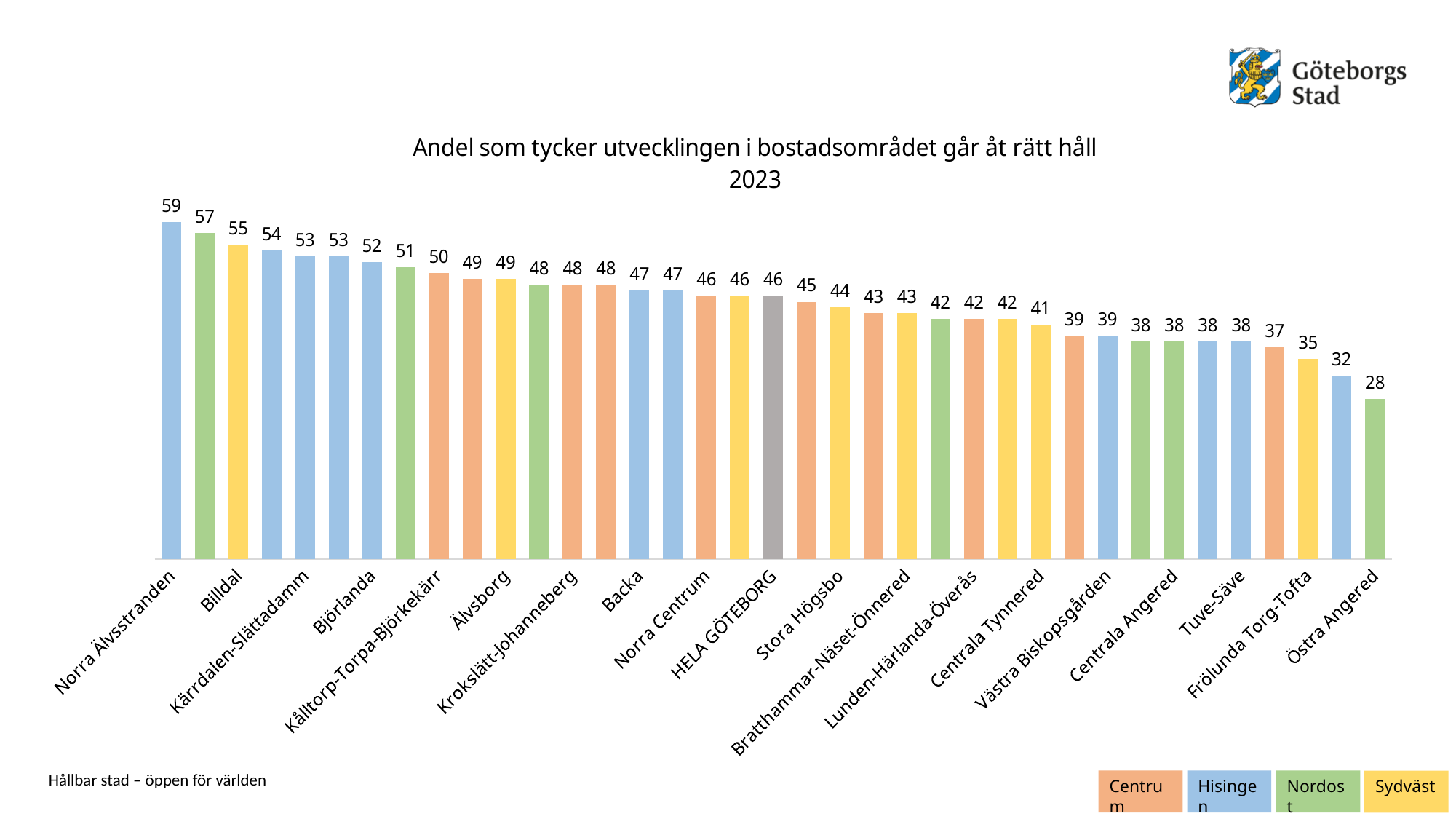
What is the difference between the values for Björlanda and Frölunda Torg-Tofta? 17 How many entries does the legend list? 4 What is the value for Norra Älvsstranden? 59 Which is larger, the value for Backa or the value for Stora Högsbo? Backa Which labelled area has the lowest value? Östra Angered Do the values rise or fall from left to right along the x axis? Fall What is the difference between the values for Norra Älvsstranden and Östra Angered? 31 What kind of chart is shown? Bar chart Which labelled area has the highest value? Norra Älvsstranden What is the value for Billdal? 55 What is the value for HELA GÖTEBORG? 46 What is the value for Östra Angered? 28